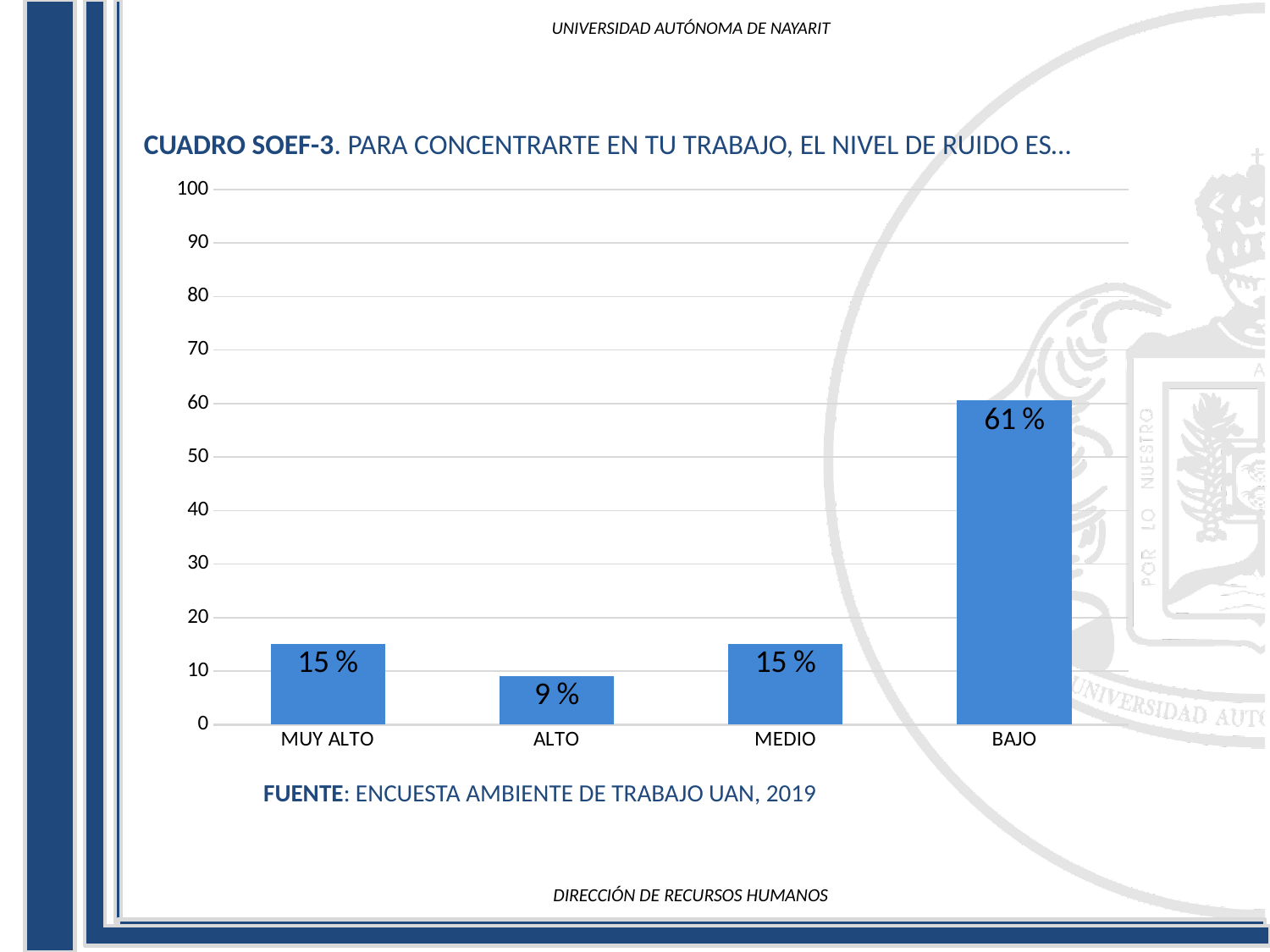
How many categories are shown on the x axis? 4 What is the difference between the values for BAJO and MEDIO? 46 % What kind of chart is shown on the slide? bar chart What is the value for MUY ALTO? 15 % What source is cited below the chart? ENCUESTA AMBIENTE DE TRABAJO UAN, 2019 Is the value for BAJO greater or less than 50? greater What is the title of the chart? CUADRO SOEF-3. PARA CONCENTRARTE EN TU TRABAJO, EL NIVEL DE RUIDO ES… What is the value for BAJO? 61 % Which category has the highest value? BAJO Which is larger, the value for ALTO or the value for MEDIO? MEDIO Which category has the lowest value? ALTO What is the value for ALTO? 9 %